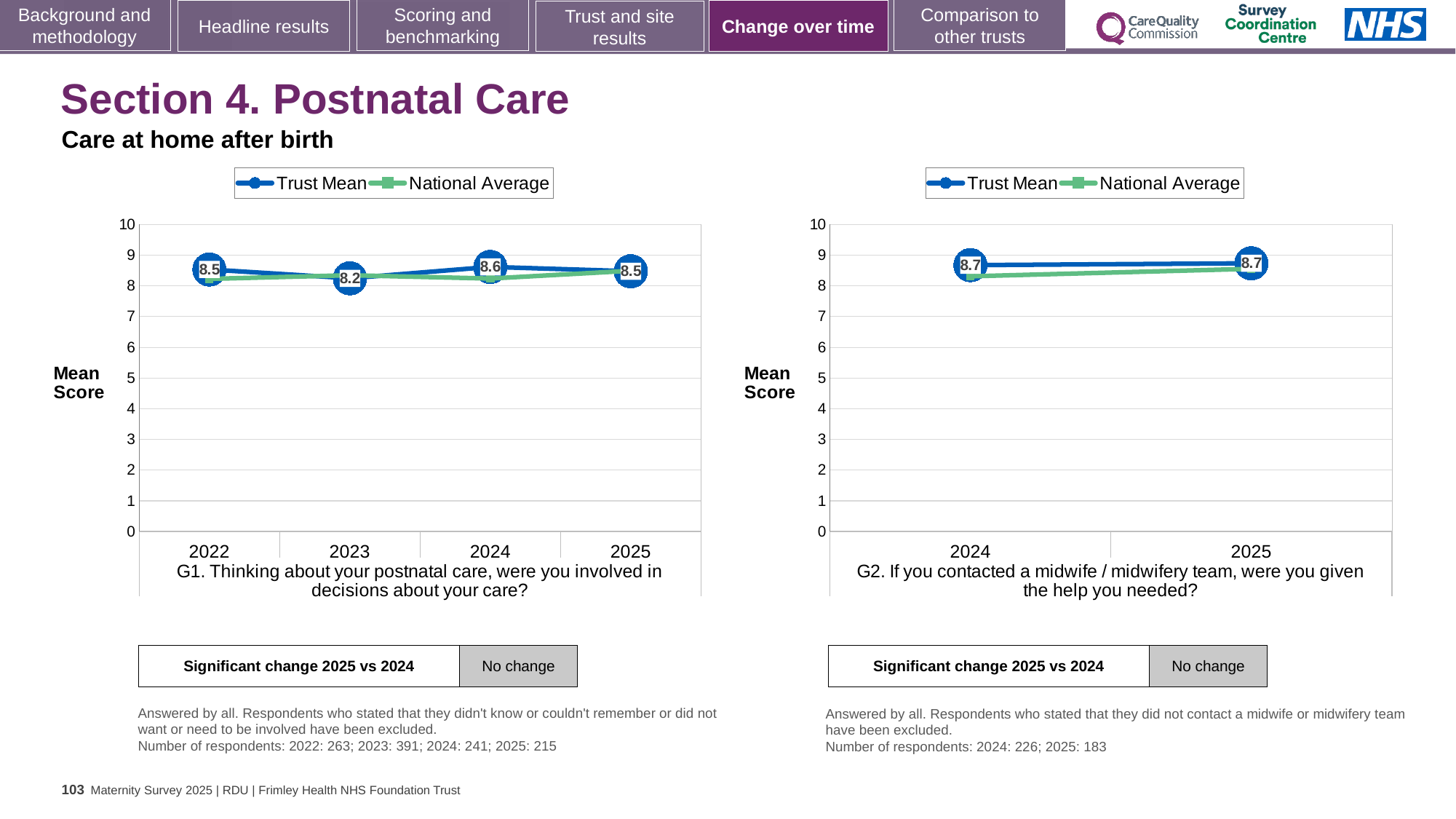
How many series does the legend of the G2 chart (right) list? 2 On the G1 chart (left), what is the Trust Mean for 2024? 8.6 On the G1 chart (left), which year has the highest Trust Mean? 2024 On the G1 chart (left), which year has the lowest Trust Mean? 2023 On the G1 chart (left), what is the difference between the Trust Mean for 2024 and 2023? 0.4 On the G2 chart (right), what is the Trust Mean for 2024? 8.7 On the G1 chart (left), what is the Trust Mean for 2025? 8.5 On the G1 chart (left), what is the Trust Mean for 2023? 8.2 On the G2 chart (right), what is the Trust Mean for 2025? 8.7 What kind of chart is the G1 chart (left)? Line chart On the G2 chart (right), is the National Average for 2024 greater or less than 9? less On the G1 chart (left), how many years are plotted on the x axis? 4